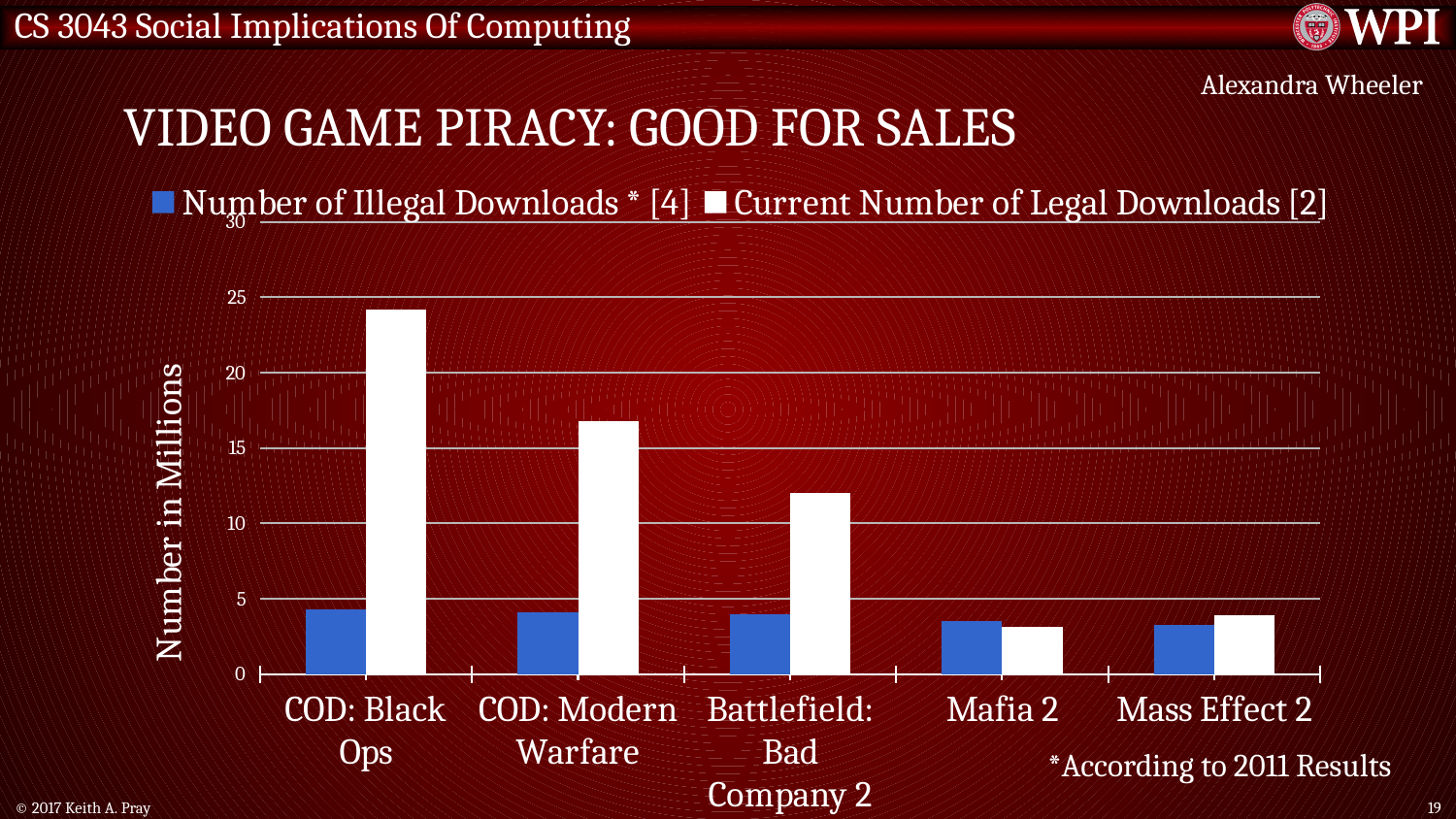
Is the Number of Illegal Downloads for Mafia 2 greater or less than 5? less Is the Current Number of Legal Downloads for COD: Black Ops greater or less than 20? greater Do the Current Number of Legal Downloads values rise or fall from COD: Black Ops to Battlefield: Bad Company 2? fall What kind of chart is shown on the slide? Bar chart Which game has the lowest Current Number of Legal Downloads? Mafia 2 How many series does the legend list? 2 What is the title of the vertical axis? Number in Millions Is the Current Number of Legal Downloads for COD: Modern Warfare greater or less than 15? greater Which game has the highest Current Number of Legal Downloads? COD: Black Ops For COD: Black Ops, which is larger: the Number of Illegal Downloads or the Current Number of Legal Downloads? Current Number of Legal Downloads How many game titles are shown on the x axis? 5